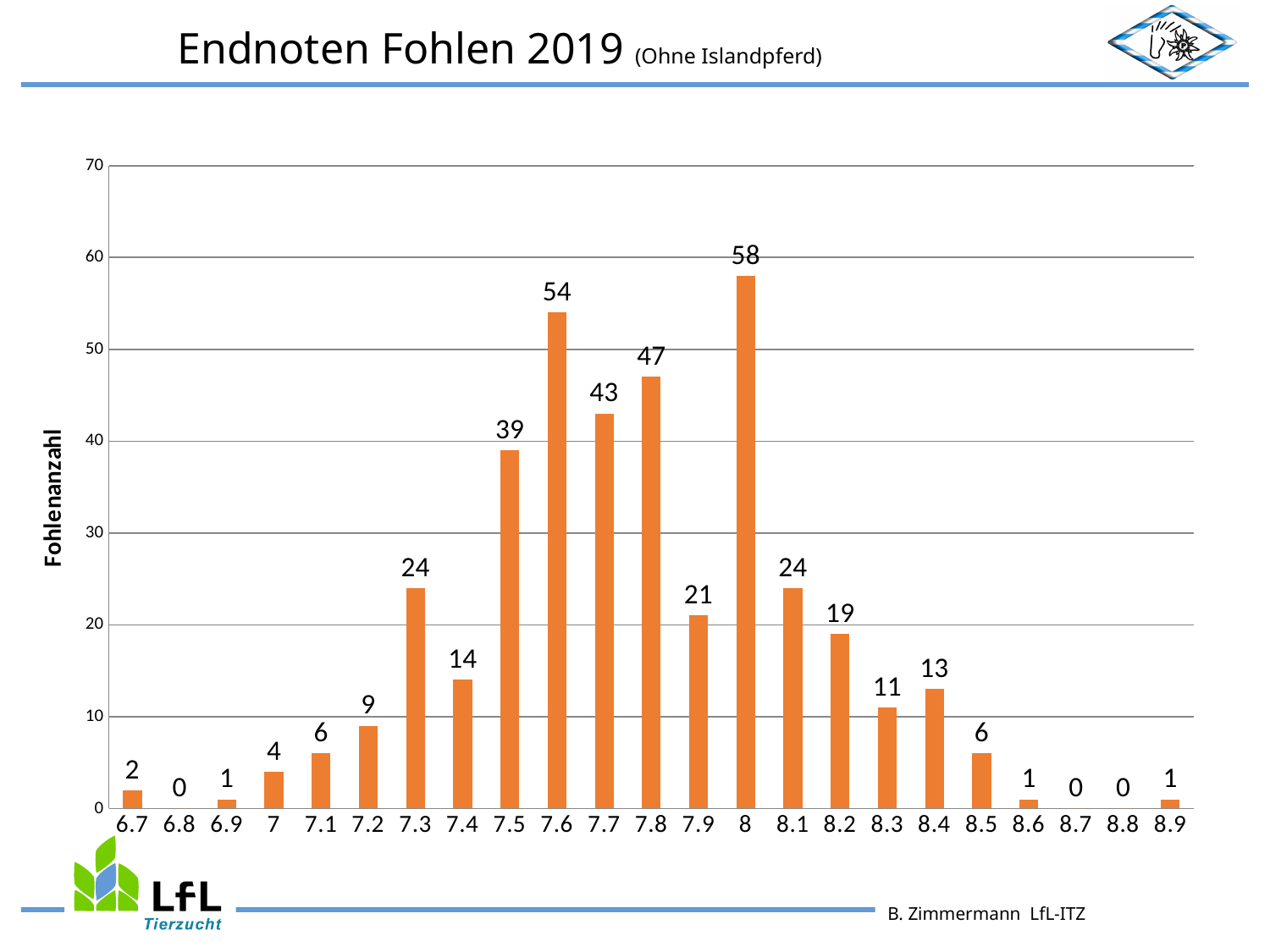
Which Endnote has the highest Fohlenanzahl? 8 What is the difference between the Fohlenanzahl for 8 and for 7.6? 4 Is the Fohlenanzahl for Endnote 7.7 greater or less than 40? greater Which has a larger Fohlenanzahl, Endnote 7.5 or Endnote 7.9? 7.5 What is the Fohlenanzahl for the Endnote 8.4? 13 What is the Fohlenanzahl for the Endnote 7.6? 54 What type of chart is shown on the slide? bar chart What is the label of the y axis? Fohlenanzahl How many Endnote categories are shown on the x axis? 23 What is the Fohlenanzahl for the Endnote 7.3? 24 What is the title of the chart slide? Endnoten Fohlen 2019 (Ohne Islandpferd) What is the difference between the Fohlenanzahl for 7.8 and for 7.7? 4